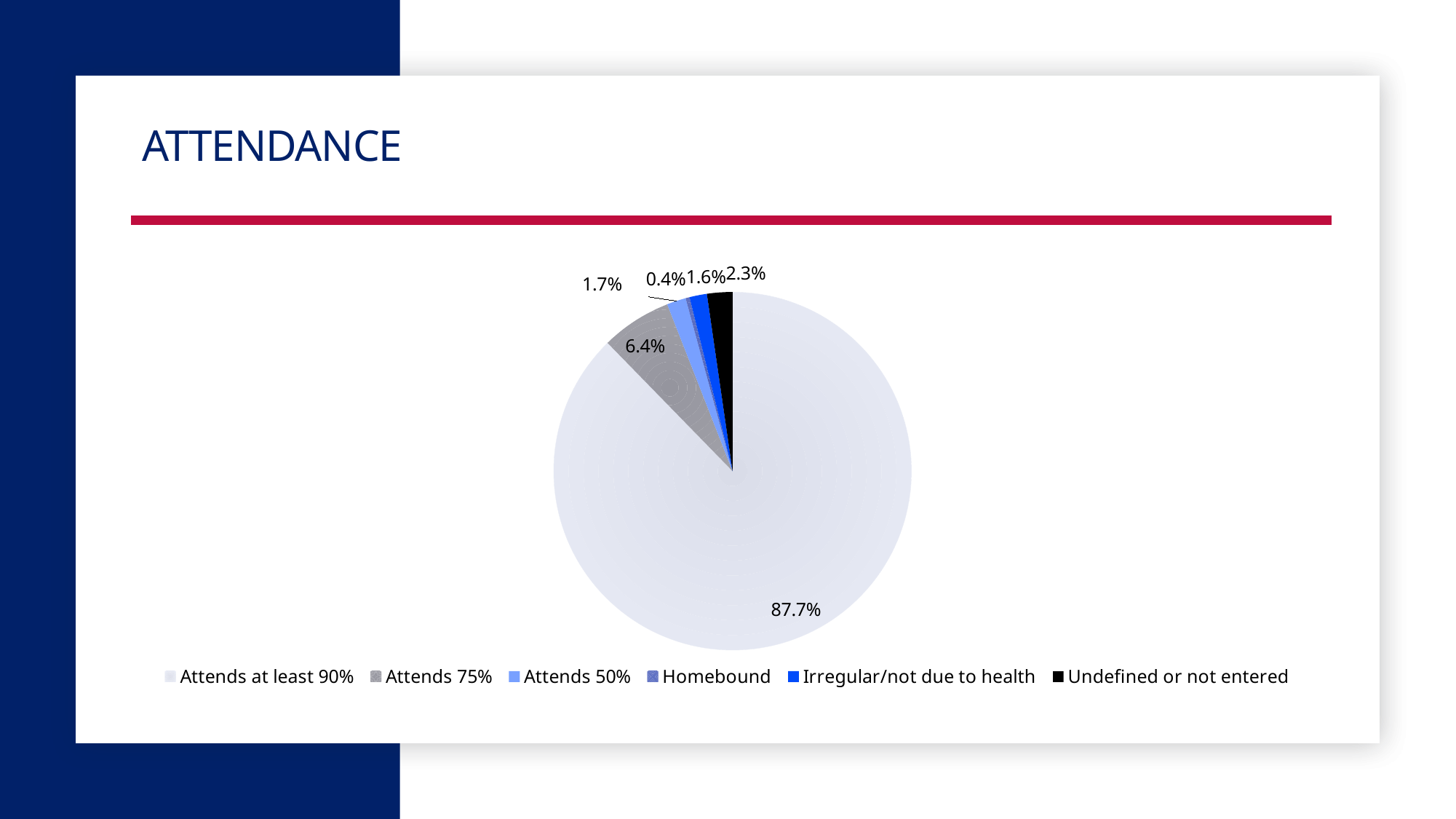
What share of the pie is labelled for 'Homebound'? 0.4% Which category has the largest slice of the pie? Attends at least 90% How many categories does the legend of the pie chart list? 6 What share of the pie is labelled for 'Irregular/not due to health'? 1.6% What share of the pie is labelled for 'Attends 75%'? 6.4% What is the difference between the shares for 'Attends 75%' and 'Attends 50%'? 4.7% Which is larger, the share for 'Undefined or not entered' or the share for 'Attends 50%'? Undefined or not entered What kind of chart is shown on the slide? pie chart Which category has the smallest slice of the pie? Homebound What is the title of the slide containing the chart? ATTENDANCE